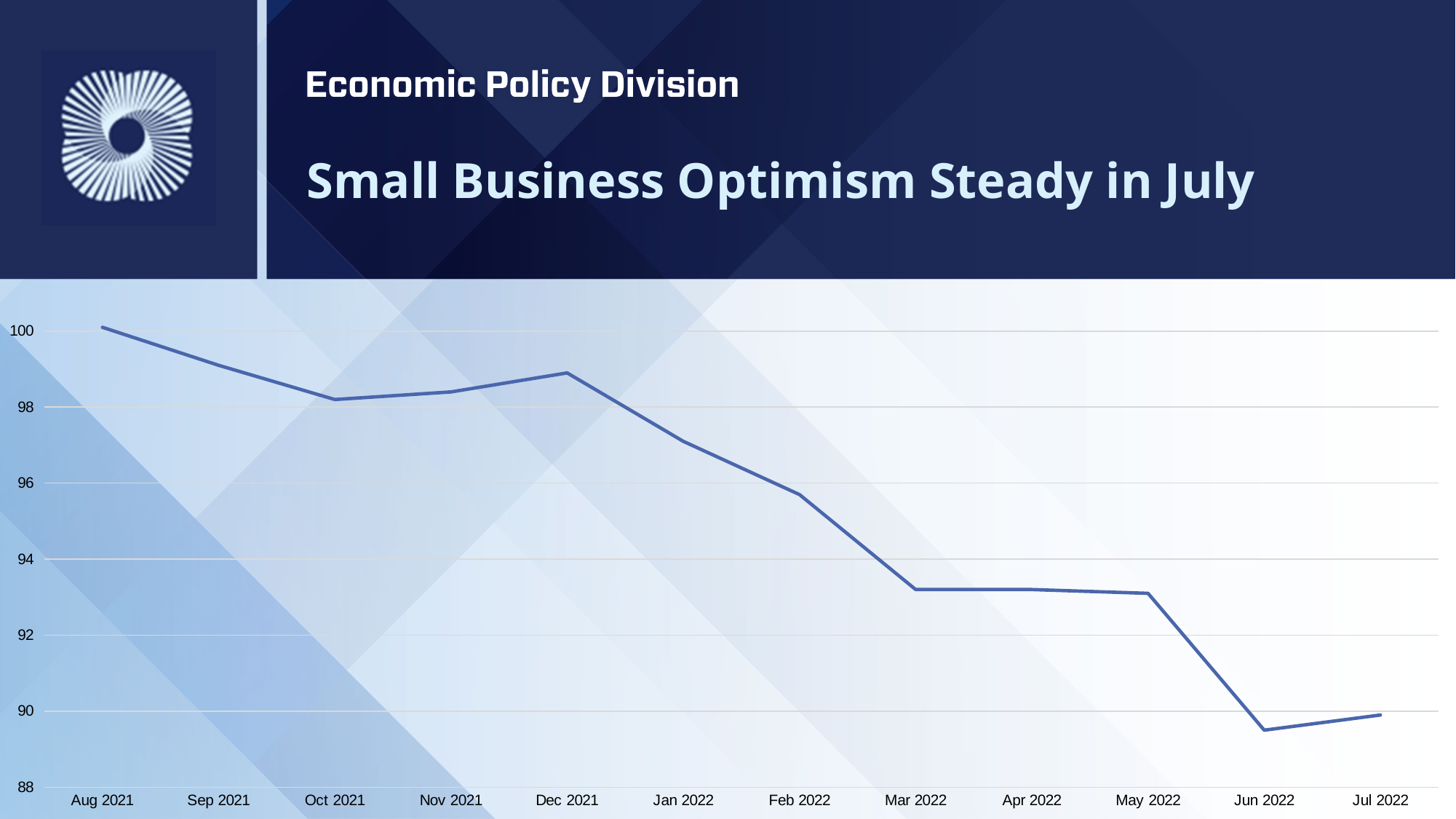
Overall, do the values rise or fall from Aug 2021 to Jul 2022? Fall Is the value for Mar 2022 greater or less than 94? less What is the title shown above the chart on the slide? Small Business Optimism Steady in July What kind of chart is shown on the slide? Line chart Which month has the lowest value on the chart? Jun 2022 Which is larger, the value for Jan 2022 or Feb 2022? Jan 2022 Is the value for Jan 2022 greater or less than 98? less Which month has the highest value on the chart? Aug 2021 Is the value for Dec 2021 greater or less than 98? greater Which is larger, the value for Nov 2021 or Dec 2021? Dec 2021 How many monthly data points are plotted on the chart? 12